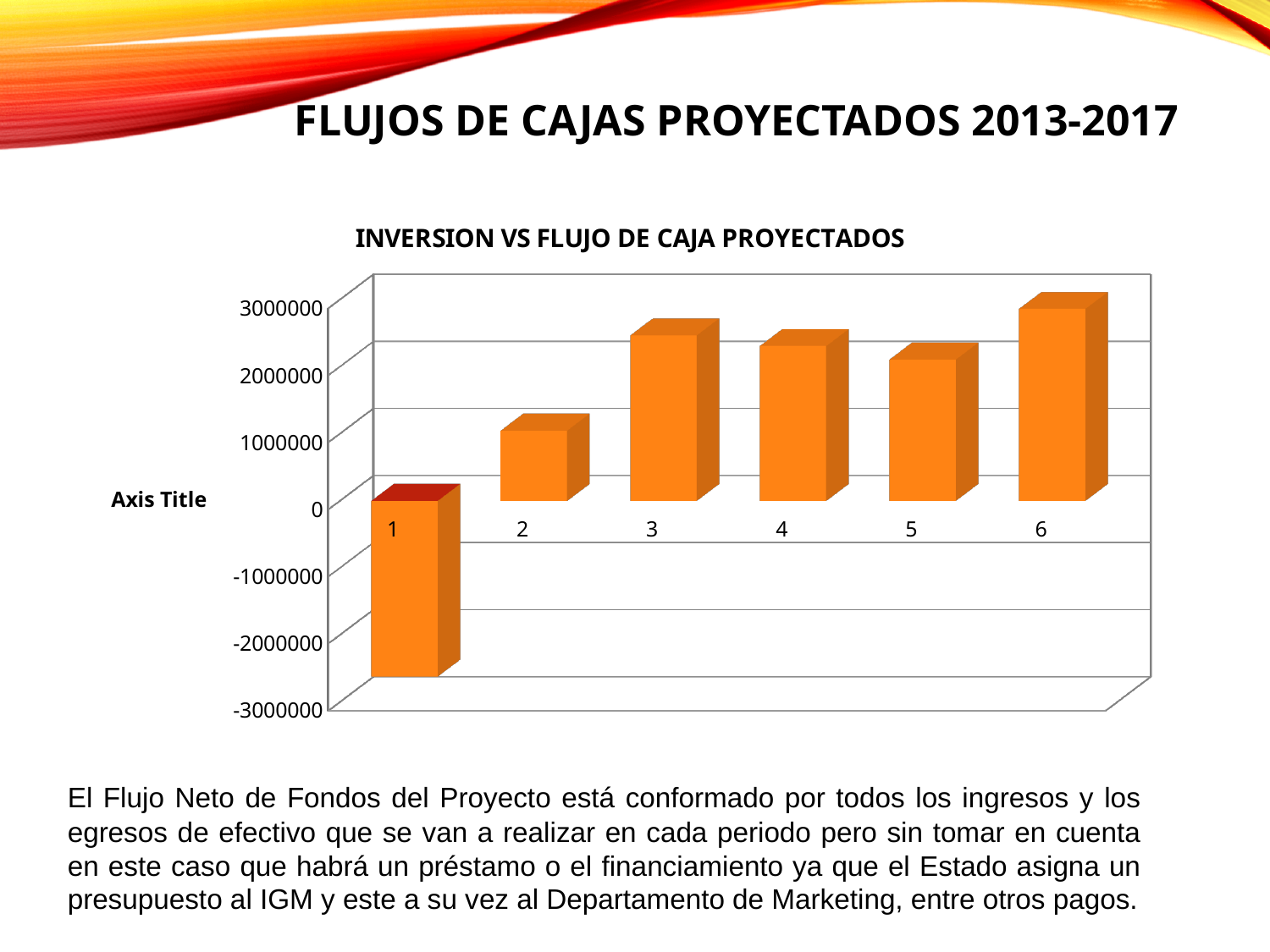
Which has the larger value, category 2 or category 3? 3 What is the title of the chart? INVERSION VS FLUJO DE CAJA PROYECTADOS Is the value for category 2 greater or less than 2000000? less Which category has the lowest value in the chart? 1 Which has the larger value, category 5 or category 6? 6 Is the value for category 3 greater or less than 2000000? greater Do the values rise or fall from category 3 to category 5? fall Which category has the highest value in the chart? 6 Is the value for category 6 greater or less than 3000000? less How many categories are plotted on the x axis of the chart? 6 What kind of chart is shown on the slide? Bar chart